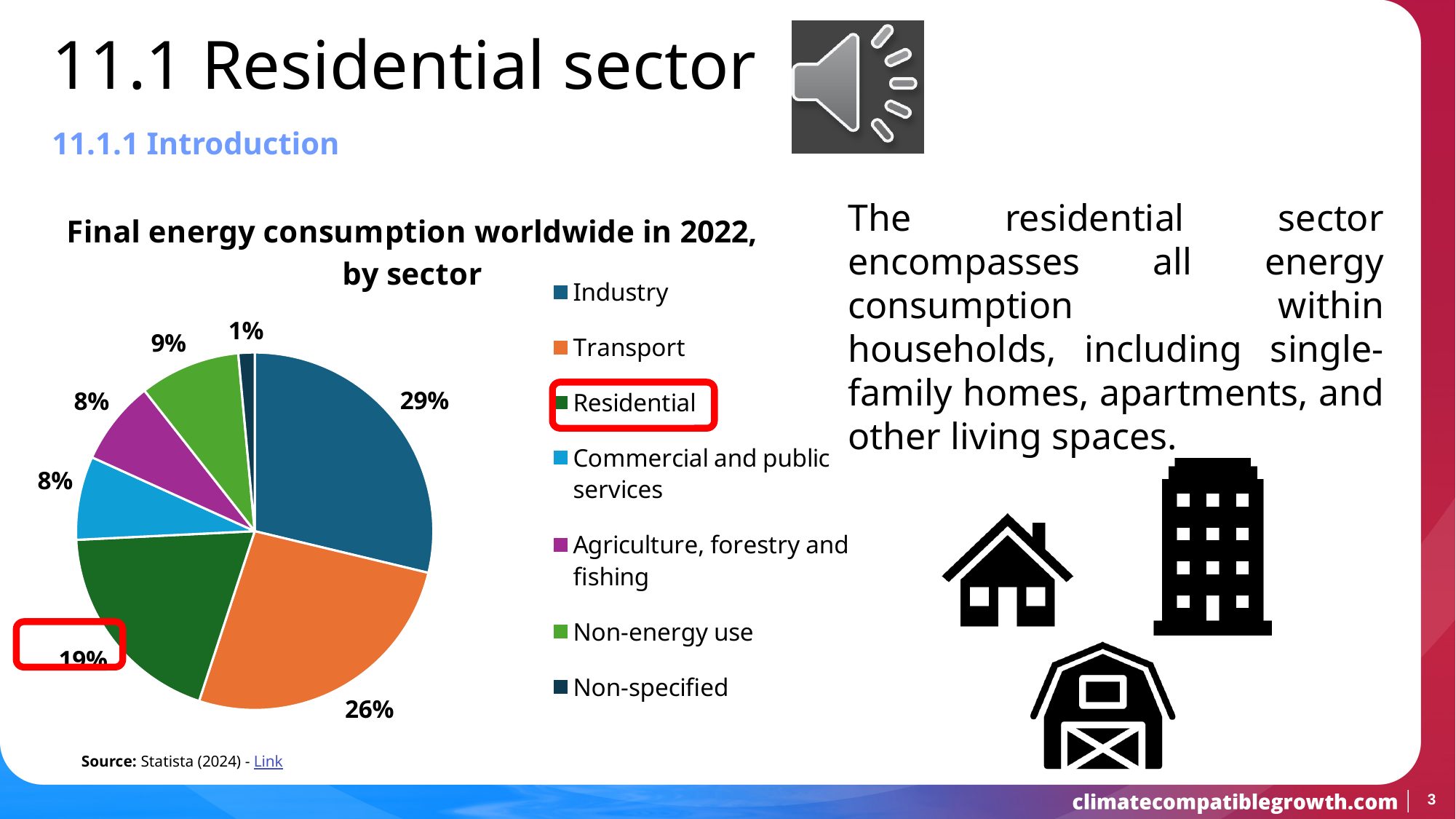
Which sector has the smallest share of final energy consumption worldwide in 2022? Non-specified How many sectors are listed in the chart legend? 7 Which sector has the largest share of final energy consumption worldwide in 2022? Industry What share of final energy consumption worldwide in 2022 is attributed to the Residential sector? 19% What is the title of the chart? Final energy consumption worldwide in 2022, by sector What share of final energy consumption worldwide in 2022 is attributed to Transport? 26% What share of final energy consumption worldwide in 2022 is attributed to Industry? 29% Which has a larger share of final energy consumption in 2022, Transport or Residential? Transport What share of final energy consumption worldwide in 2022 is attributed to Non-specified? 1% What share of final energy consumption worldwide in 2022 is attributed to Non-energy use? 9% What is the difference in percentage points between the Industry share and the Residential share? 10 What type of chart is shown on the slide? pie chart